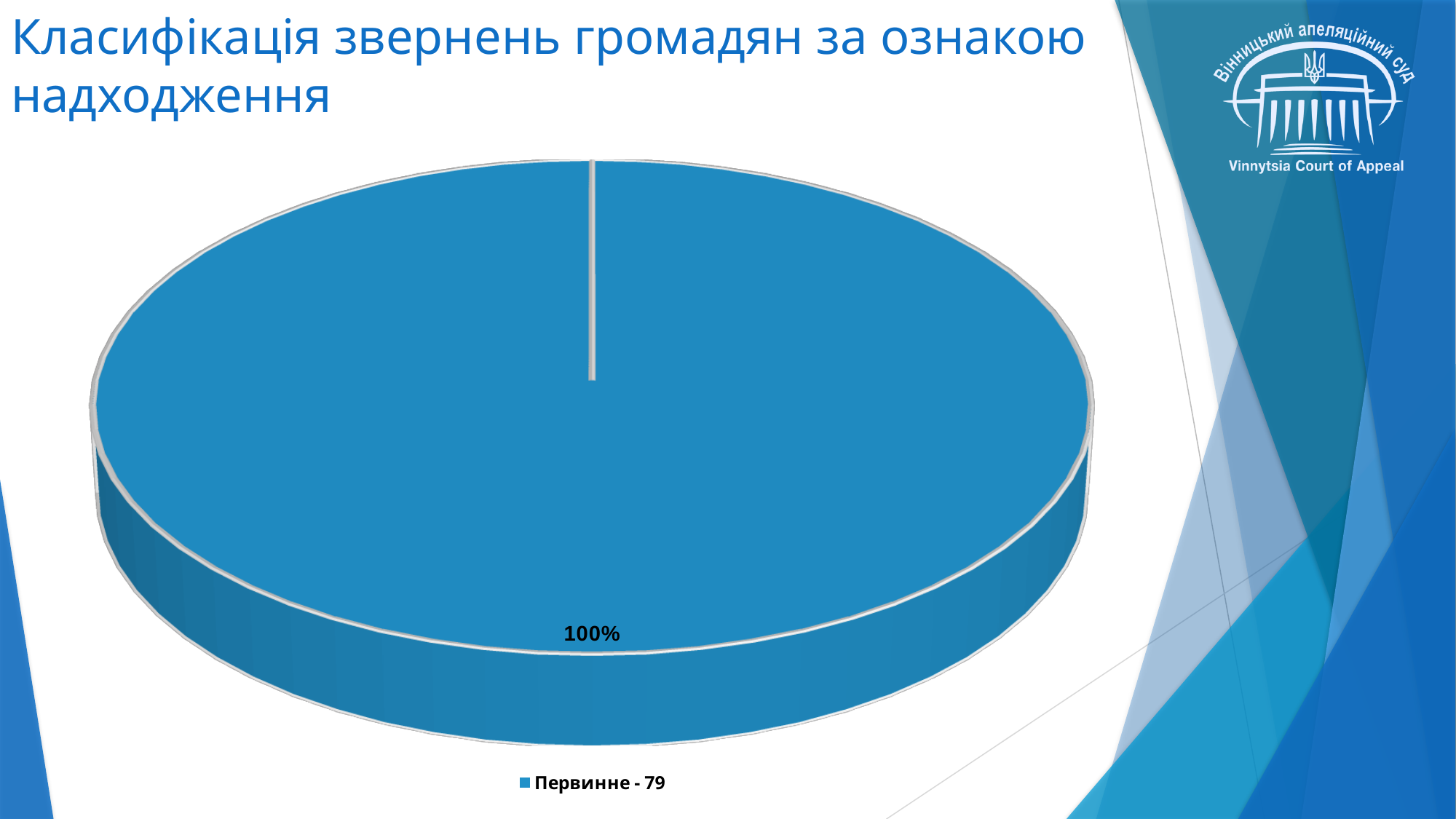
What is the legend entry shown below the pie chart? Первинне - 79 How many entries does the legend list? 1 What is the title of the slide containing the pie chart? Класифікація звернень громадян за ознакою надходження What number is given in the legend entry for "Первинне"? 79 What share of the pie does the "Первинне - 79" slice take? 100% What percentage is printed on the pie slice? 100% What kind of chart is shown on the slide? Pie chart How many slices does the pie chart have? 1